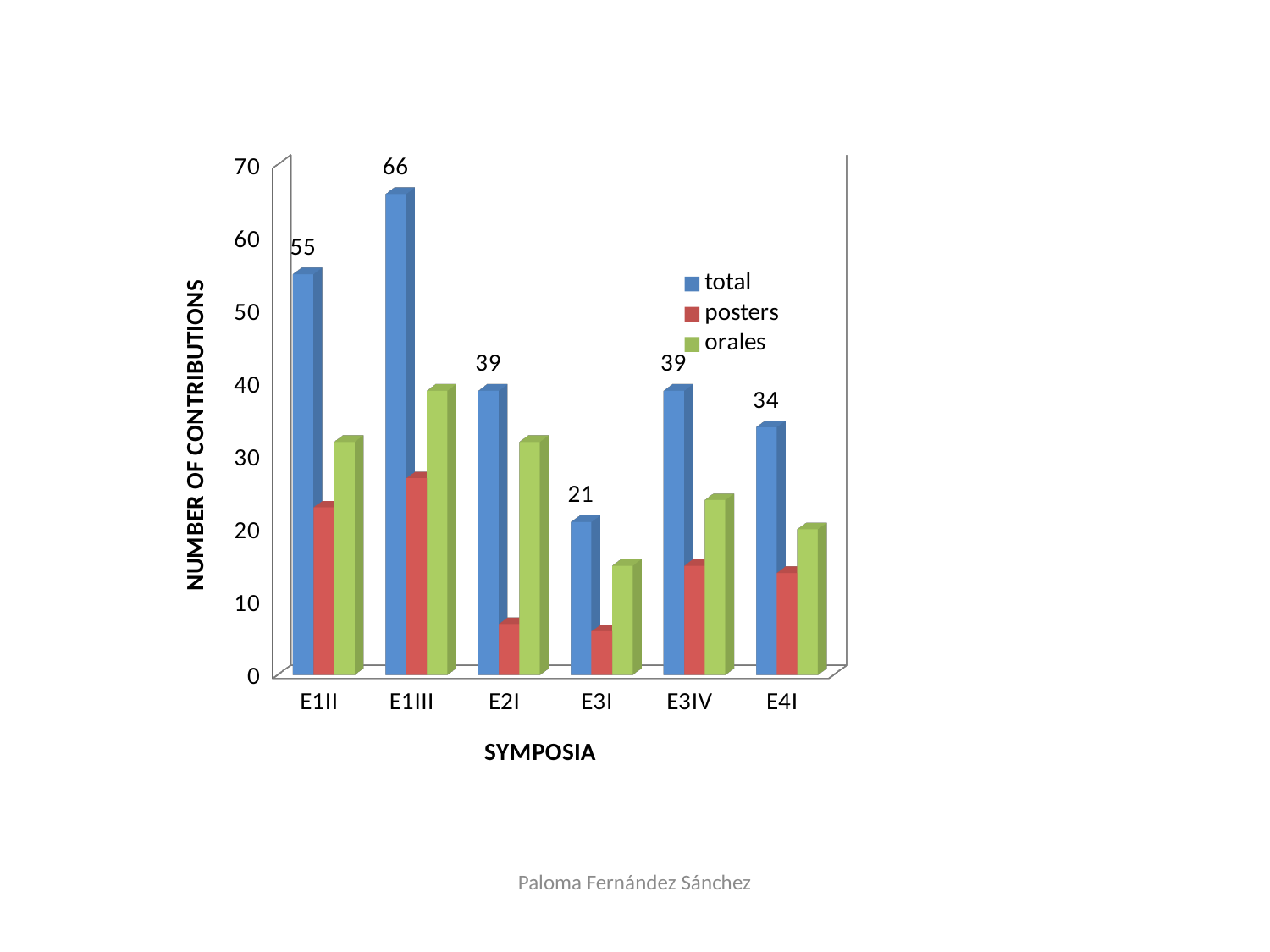
Which symposium has the lowest total number of contributions? E3I What kind of chart is shown on the slide? Bar chart Is the posters value for E2I greater or less than 10? less How many series does the legend list? 3 Which has a larger total number of contributions, E1II or E4I? E1II What is the total number of contributions for symposium E4I? 34 Is the orales value for E3I greater or less than 20? less Which symposium has the highest total number of contributions? E1III What is the total number of contributions for symposium E1III? 66 What is the difference between the total contributions for E1III and E1II? 11 How many symposia are shown on the x axis? 6 Is the orales value for E1III greater or less than 30? greater